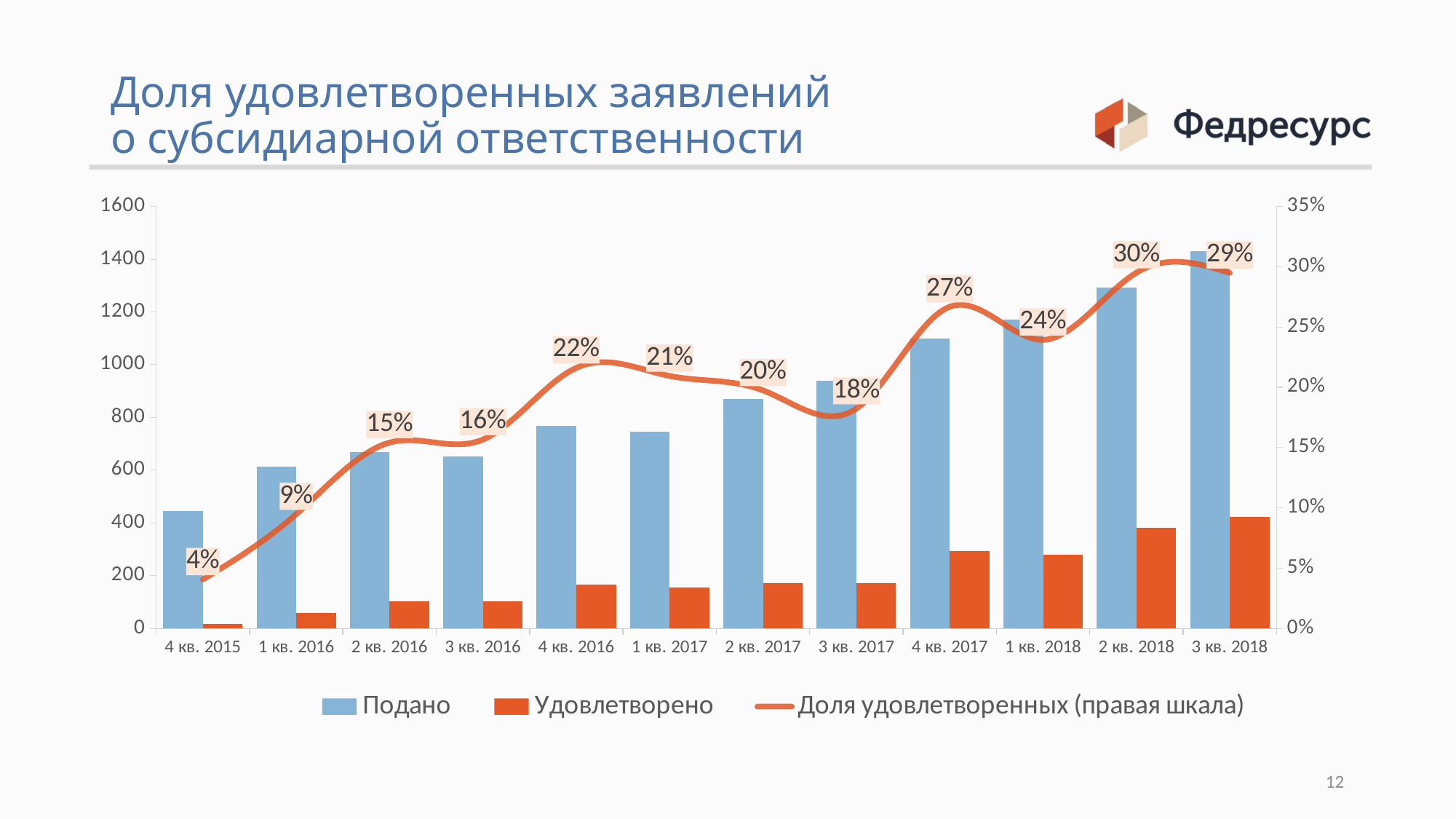
What is the value of the 'Доля удовлетворенных' line for 4 кв. 2015? 4% What is the value of the 'Доля удовлетворенных' line for 4 кв. 2017? 27% Which quarter has a higher 'Доля удовлетворенных' value: 4 кв. 2016 or 3 кв. 2017? 4 кв. 2016 In which quarter is the 'Доля удовлетворенных' line at its lowest? 4 кв. 2015 Does the 'Доля удовлетворенных' line generally rise or fall from 4 кв. 2015 to 3 кв. 2018? rise How many series does the legend list? 3 What is the value of the 'Доля удовлетворенных' line for 3 кв. 2018? 29% Is the 'Подано' value for 3 кв. 2018 greater or less than 1200? greater How many quarters are shown on the x axis? 12 What is the difference between the 'Доля удовлетворенных' values for 2 кв. 2018 and 4 кв. 2015? 26% Is the 'Подано' value for 4 кв. 2015 greater or less than 600? less In which quarter is the 'Доля удовлетворенных' line at its highest? 2 кв. 2018